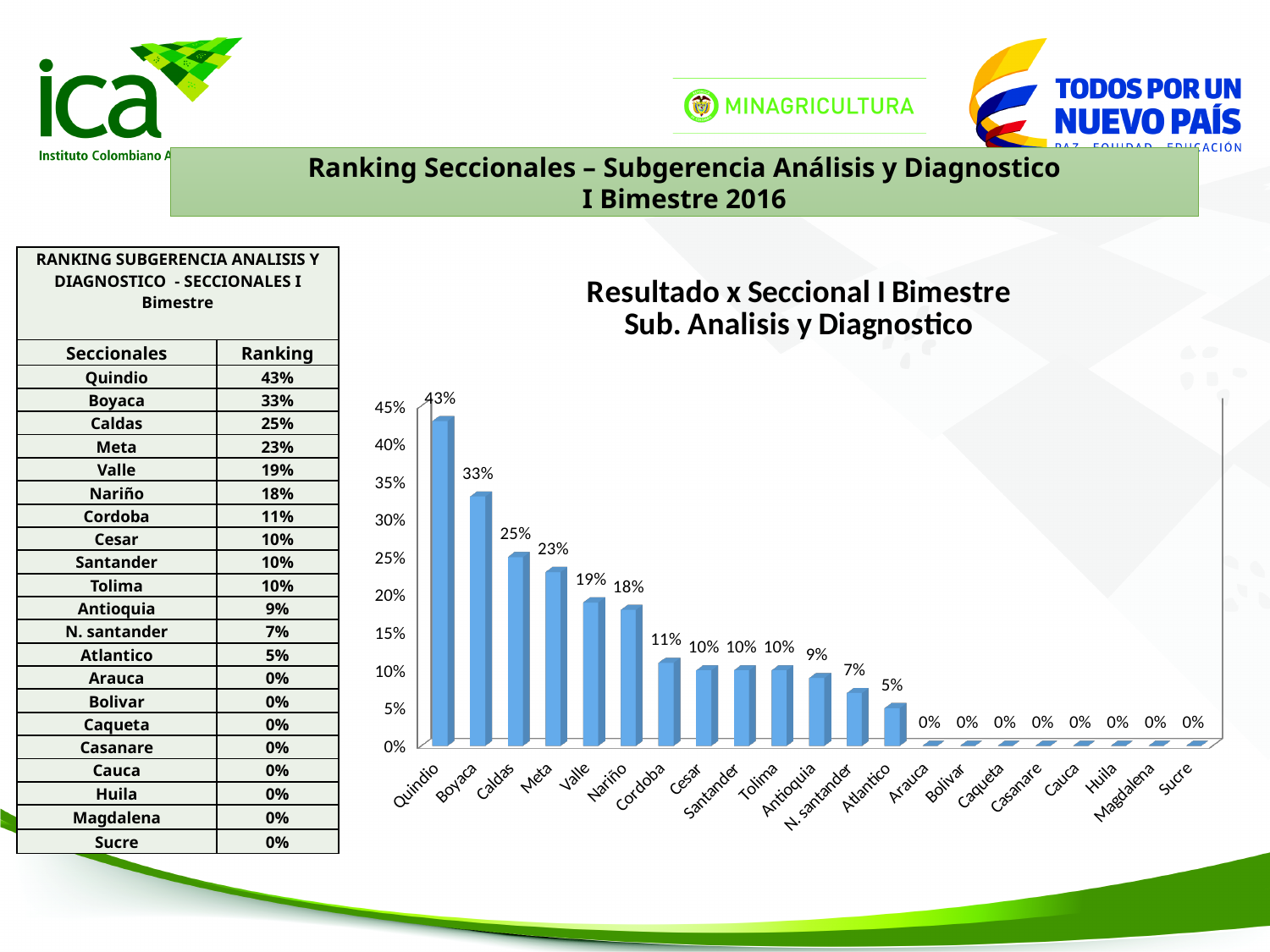
Which seccional has the highest value in the chart? Quindio What is the difference between the values for Caldas and Cordoba? 14% Which has a larger value, Meta or Valle? Meta Which has a larger value, Antioquia or N. santander? Antioquia How many seccionales have a value of 0% in the chart? 8 Do the values rise or fall from left to right along the x axis? Fall What is the difference between the values for Quindio and Boyaca? 10% What kind of chart is shown on the slide? Bar chart What is the value for Atlantico in the chart? 5% How many seccionales are shown on the x axis of the chart? 21 What is the value for Nariño in the chart? 18% What is the value for Quindio in the chart? 43%